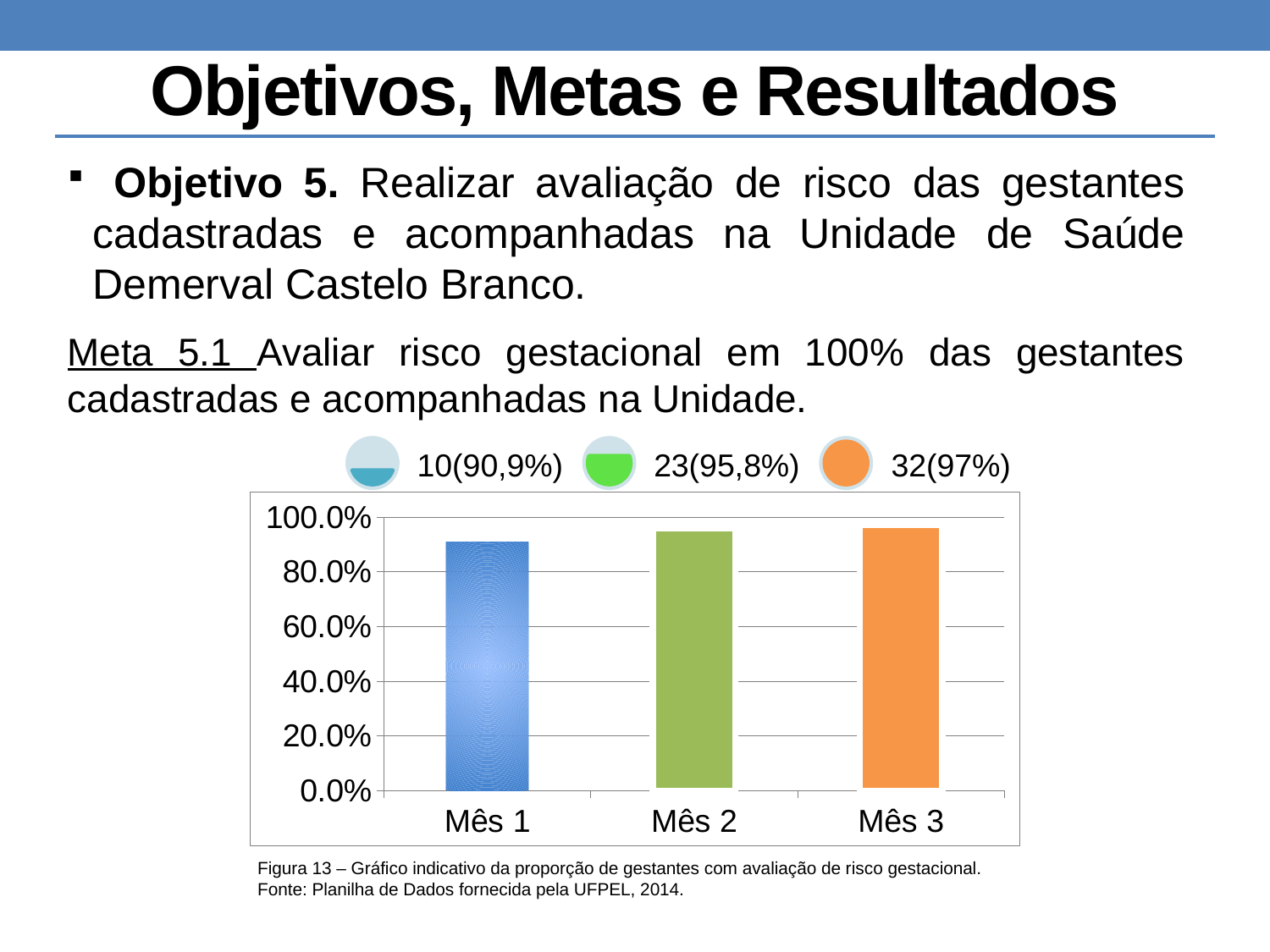
Which month has the highest bar in the chart? Mês 3 Which is larger, the value for Mês 1 or the value for Mês 3? Mês 3 What is the figure number given in the caption below the chart? Figura 13 How many categories are shown on the x axis of the chart? 3 What is the legend label for the blue bar (Mês 1)? 10(90,9%) Do the bar values rise or fall from Mês 1 to Mês 3? rise What kind of chart is shown on the slide? bar chart Which month has the lowest bar in the chart? Mês 1 What is the legend label for the green bar (Mês 2)? 23(95,8%) What is the legend label for the orange bar (Mês 3)? 32(97%) How many entries does the chart's legend list? 3 Is the value for Mês 1 greater or less than 80.0%? greater